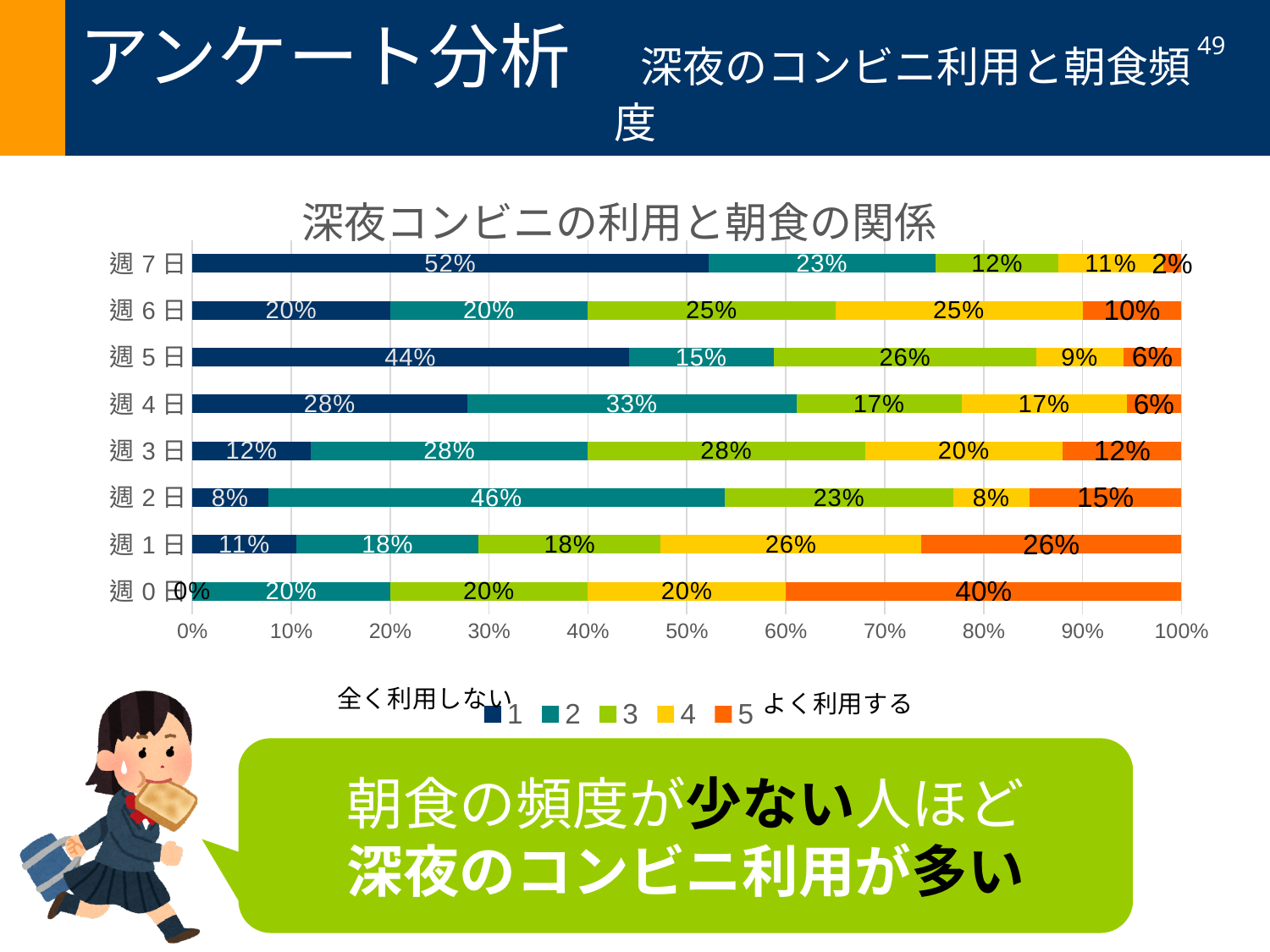
What is the value of series 2 for 週２日? 46% What type of chart is shown on the slide? Stacked bar chart Which category has the highest value for series 1? 週７日 Which is larger: series 1 for 週５日 or series 1 for 週４日? 週５日 What is the value of series 3 for 週６日? 25% What is the value of series 5 for 週０日? 40% Which category has the lowest value for series 5? 週７日 What is the difference between the series 5 values for 週０日 and 週１日? 14% How many categories (rows) are plotted in the chart? 8 What is the value of series 1 for 週７日? 52% How many series does the legend list? 5 What is the title of the chart? 深夜コンビニの利用と朝食の関係